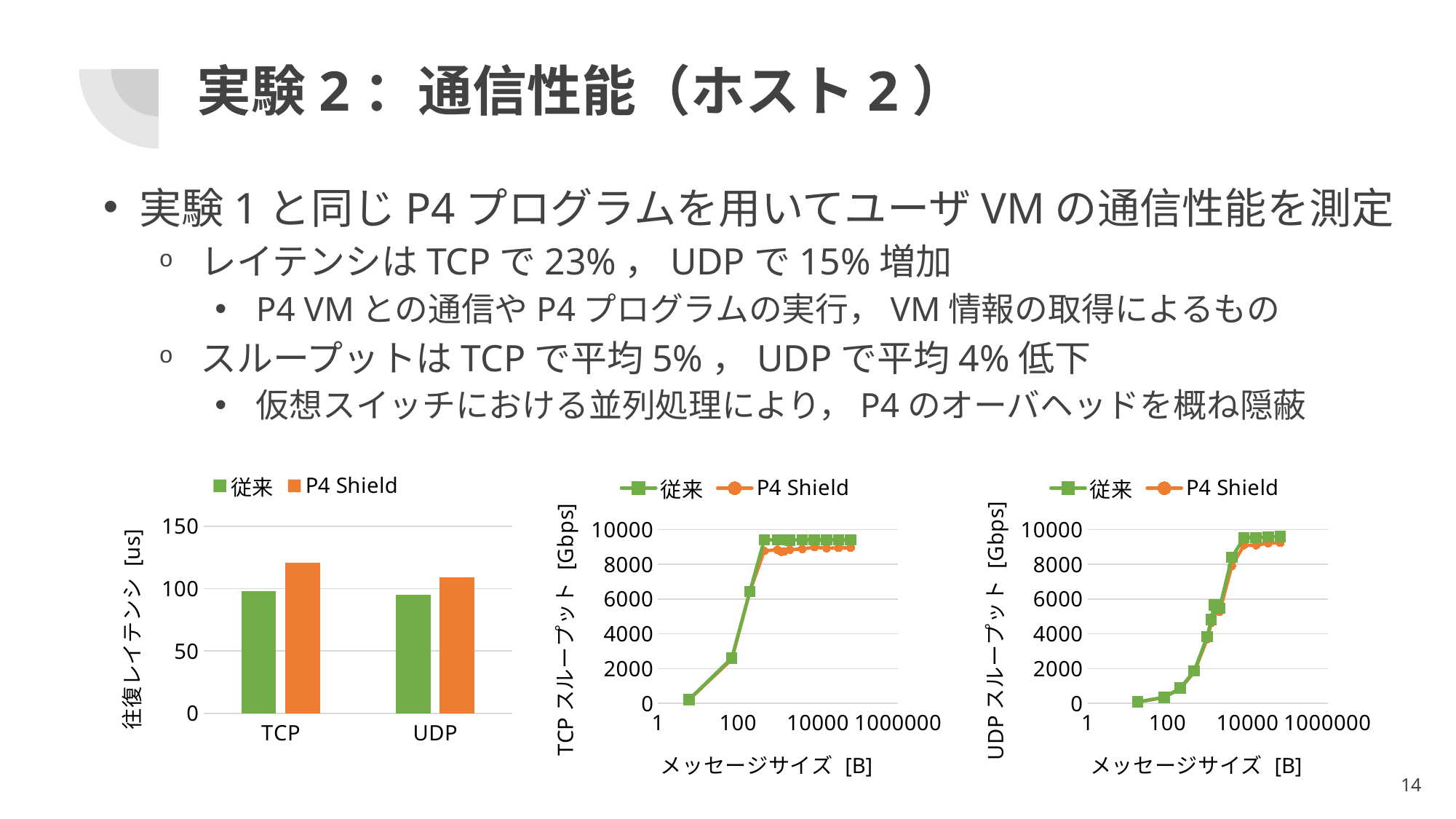
In the middle chart (TCP スループット), do the values rise or fall as message size increases? rise In the rightmost chart (UDP スループット), what is the x-axis label? メッセージサイズ [B] In the leftmost chart (往復レイテンシ), which is larger for UDP: 従来 or P4 Shield? P4 Shield What kind of chart is the middle chart (TCP スループット)? line chart In the leftmost chart (往復レイテンシ), which is larger for TCP: 従来 or P4 Shield? P4 Shield What kind of chart is the leftmost chart (往復レイテンシ)? bar chart In the rightmost chart (UDP スループット), what are the two series listed in the legend? 従来 and P4 Shield In the leftmost chart (往復レイテンシ), how many categories are shown on the x axis? 2 In the leftmost chart (往復レイテンシ), is the P4 Shield value for TCP greater or less than 100? greater In the leftmost chart (往復レイテンシ), which bar is the highest? P4 Shield for TCP In the leftmost chart (往復レイテンシ), is the P4 Shield value for UDP greater or less than 100? greater In the leftmost chart (往復レイテンシ), how many series does the legend list? 2